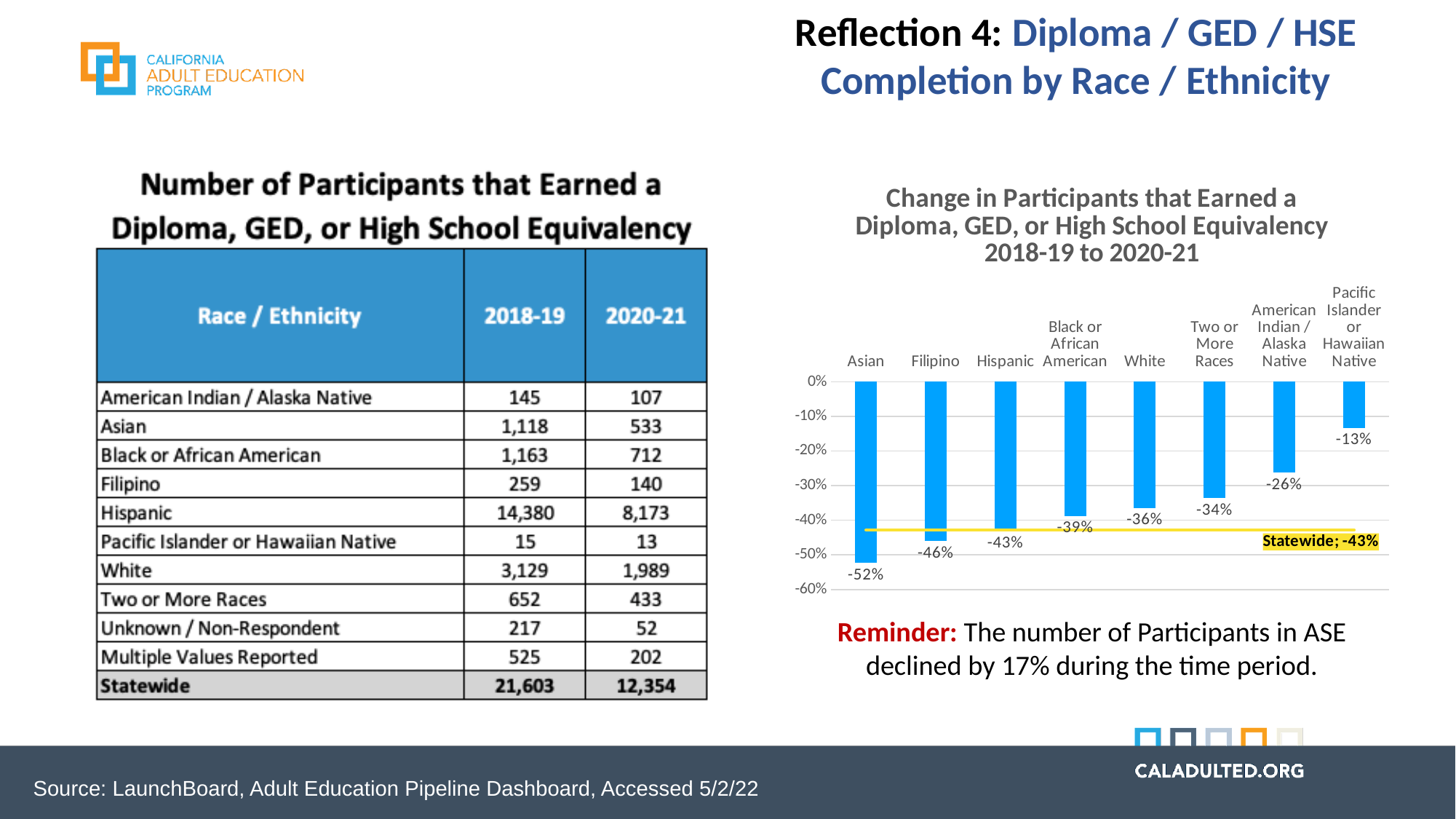
How many race/ethnicity categories are plotted as bars in the chart? 8 Which category shows the smallest decline in the chart? Pacific Islander or Hawaiian Native Which category has a larger decline in the chart, Hispanic or White? Hispanic What is the Statewide value marked by the line in the chart? -43% What is the value for White in the chart? -36% What is the value for Asian in the chart? -52% What is the title of the chart on the right of the slide? Change in Participants that Earned a Diploma, GED, or High School Equivalency 2018-19 to 2020-21 Do the bar values become less negative or more negative moving from left to right along the x axis of the chart? Less negative What kind of chart is shown on the right of the slide? Bar chart Which category shows the largest decline in the chart? Asian What is the difference between the values for Asian and Filipino in the chart? 6 percentage points What is the value for Pacific Islander or Hawaiian Native in the chart? -13%